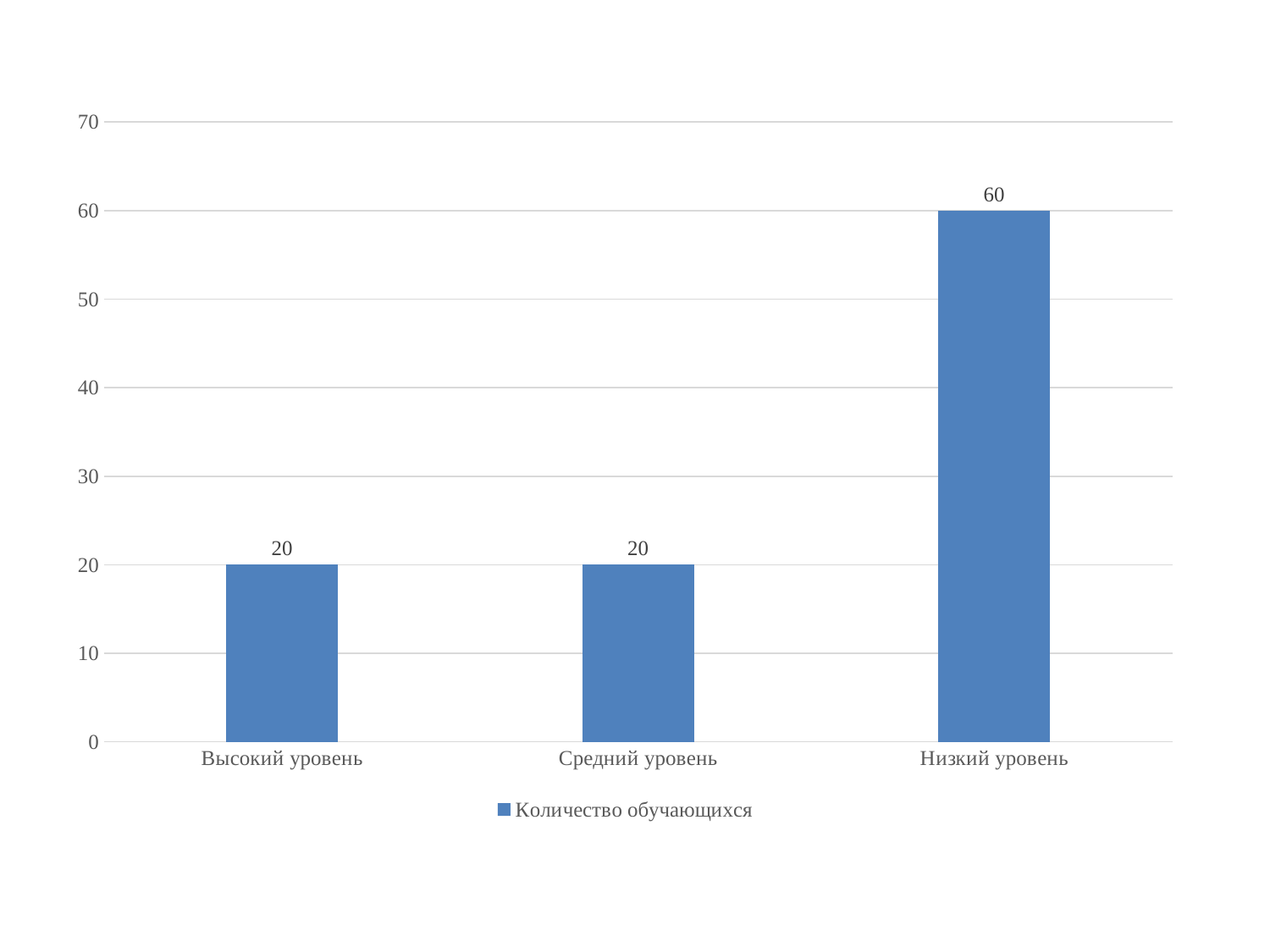
What is the value for Низкий уровень? 60 How many series does the legend list? 1 Is the value for Низкий уровень greater or less than 50? greater What kind of chart is shown on the slide? bar chart What is the name of the series shown in the legend? Количество обучающихся What is the difference between the values for Низкий уровень and Высокий уровень? 40 Which category has the highest value? Низкий уровень How many categories are shown on the x axis? 3 Which is larger, the value for Низкий уровень or the value for Средний уровень? Низкий уровень Is the value for Высокий уровень greater or less than 30? less What is the value for Высокий уровень? 20 What is the value for Средний уровень? 20